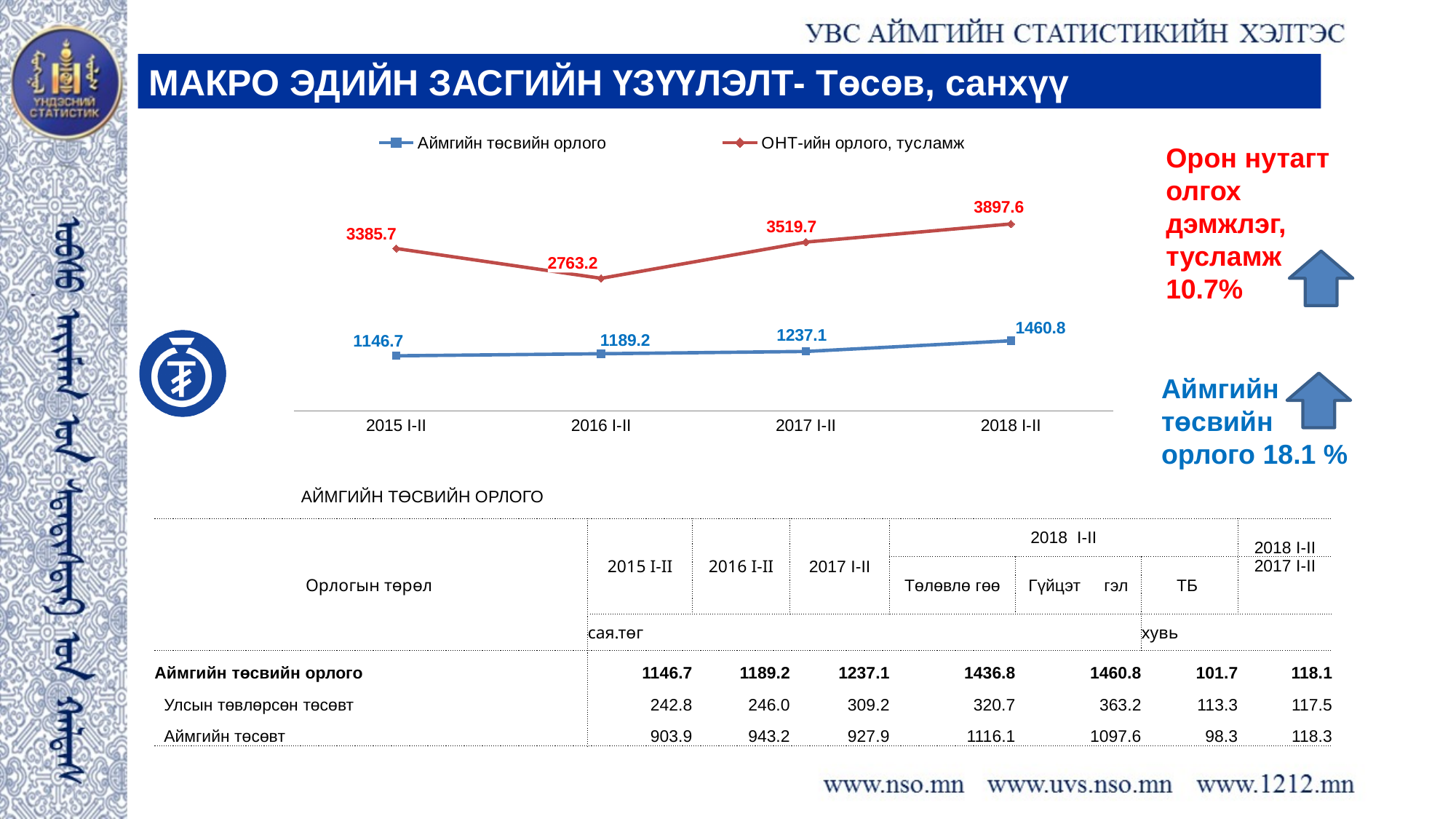
How many series does the chart legend list? 2 What is the value of Аймгийн төсвийн орлого for 2018 I-II? 1460.8 In which period is ОНТ-ийн орлого, тусламж lowest? 2016 I-II Which series has the larger value in 2015 I-II, Аймгийн төсвийн орлого or ОНТ-ийн орлого, тусламж? ОНТ-ийн орлого, тусламж In which period is ОНТ-ийн орлого, тусламж highest? 2018 I-II What is the difference between ОНТ-ийн орлого, тусламж and Аймгийн төсвийн орлого in 2017 I-II? 2282.6 Does Аймгийн төсвийн орлого rise or fall from 2015 I-II to 2018 I-II? rise What colour is the line for ОНТ-ийн орлого, тусламж? red What type of chart is shown on the slide? line chart How many time periods are plotted along the x axis of the chart? 4 What is the value of ОНТ-ийн орлого, тусламж for 2016 I-II? 2763.2 What is the value of Аймгийн төсвийн орлого for 2015 I-II? 1146.7